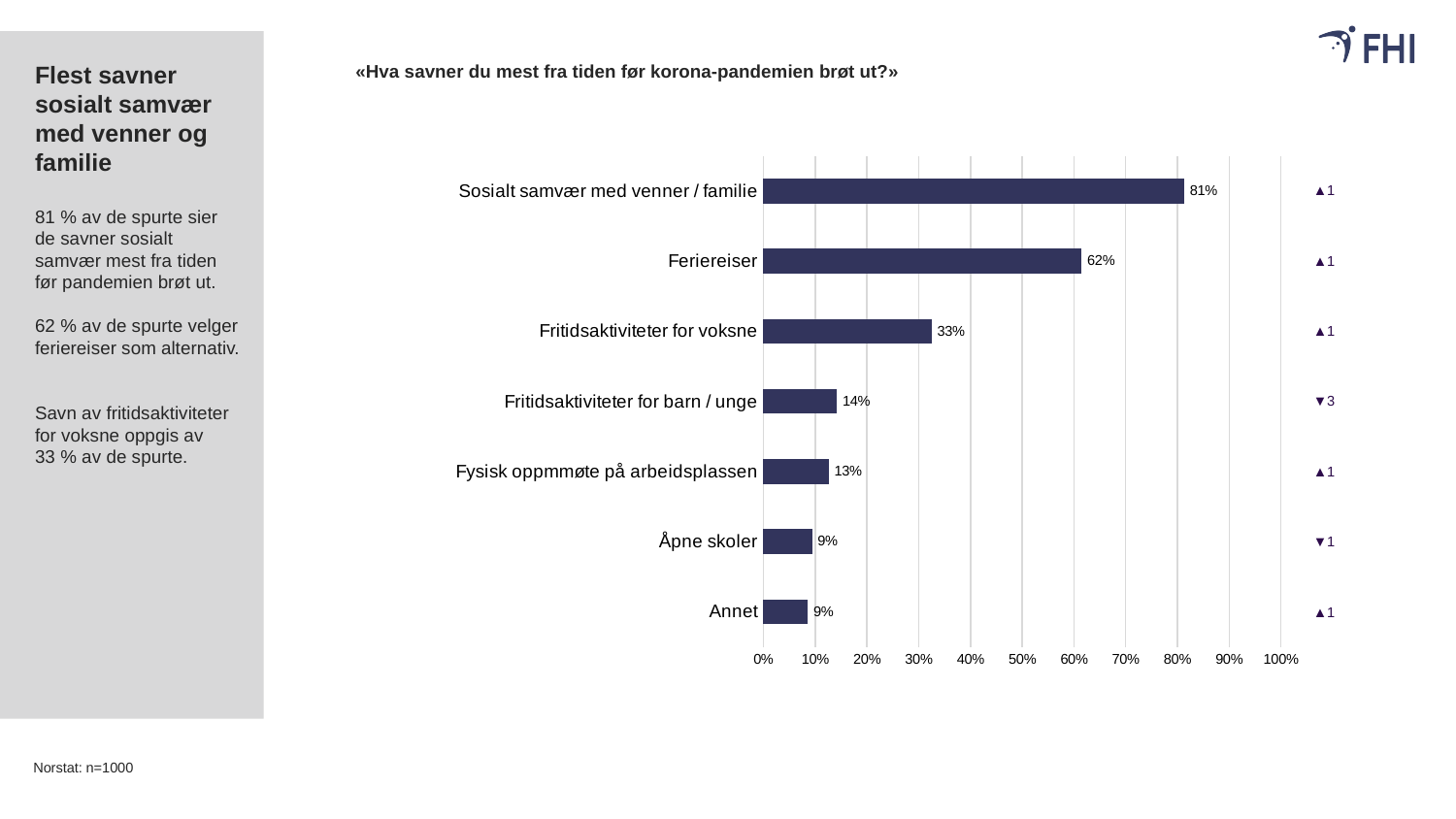
How many categories are shown in the chart? 7 What is the value for Feriereiser? 62% What is the value for Sosialt samvær med venner / familie? 81% What kind of chart is shown on the slide? bar chart What is the difference between the values for Fritidsaktiviteter for voksne and Fritidsaktiviteter for barn / unge? 19% What is the difference between the values for Sosialt samvær med venner / familie and Feriereiser? 19% Which is larger, the value for Feriereiser or the value for Fritidsaktiviteter for voksne? Feriereiser What is the title of the chart? «Hva savner du mest fra tiden før korona-pandemien brøt ut?» What is the value for Fysisk oppmmøte på arbeidsplassen? 13% Which category has the highest value? Sosialt samvær med venner / familie What is the value for Fritidsaktiviteter for barn / unge? 14% Is the value for Fritidsaktiviteter for voksne greater or less than 40%? less